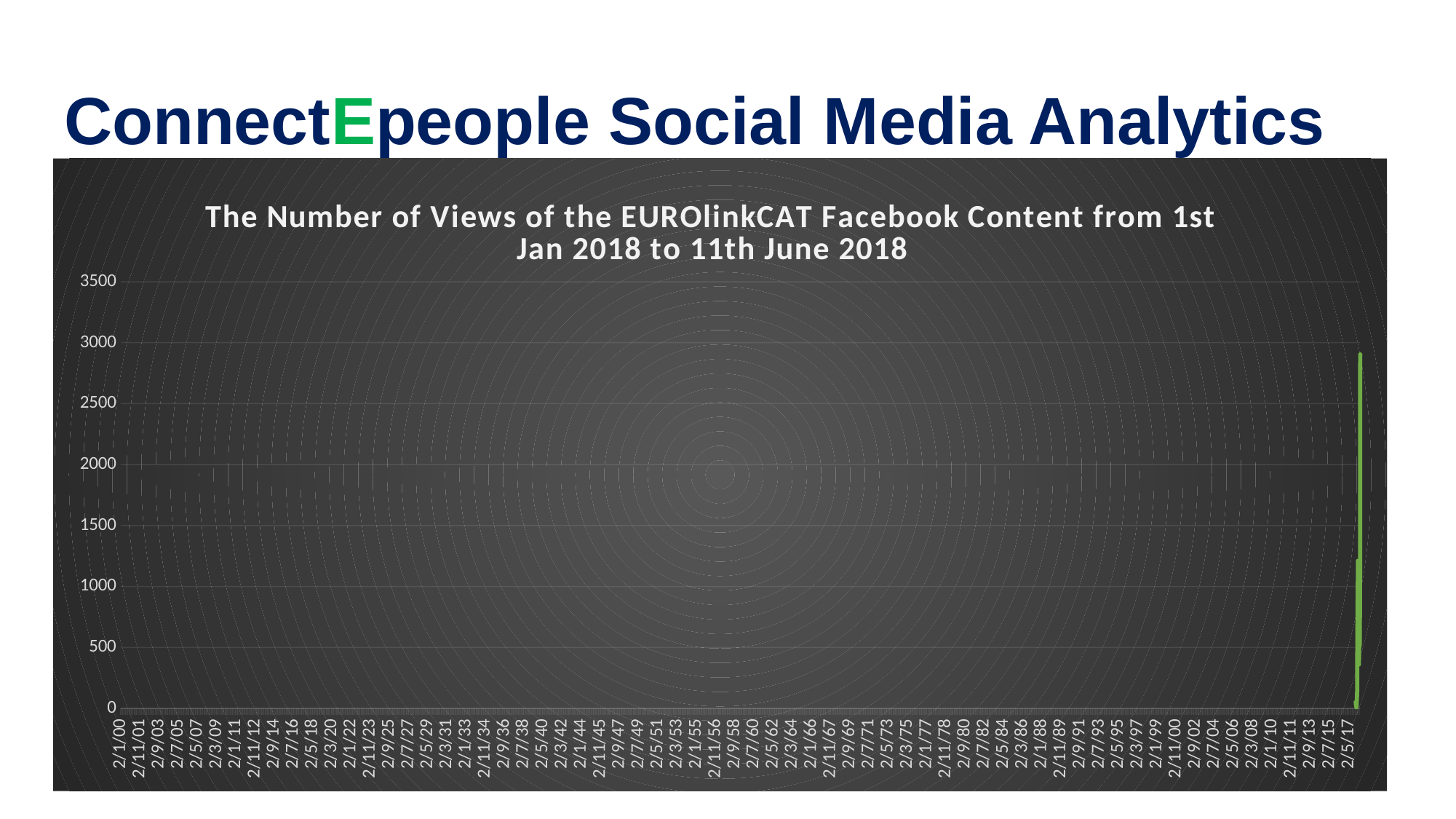
What is the highest value shown on the vertical axis of the chart? 3500 What is the title of the chart? The Number of Views of the EUROlinkCAT Facebook Content from 1st Jan 2018 to 11th June 2018 Is the peak value of the line greater or less than 2500? greater What kind of chart is shown on the slide? line chart Is the peak value of the line greater or less than 1000? greater Is the peak value of the line greater or less than 3500? less